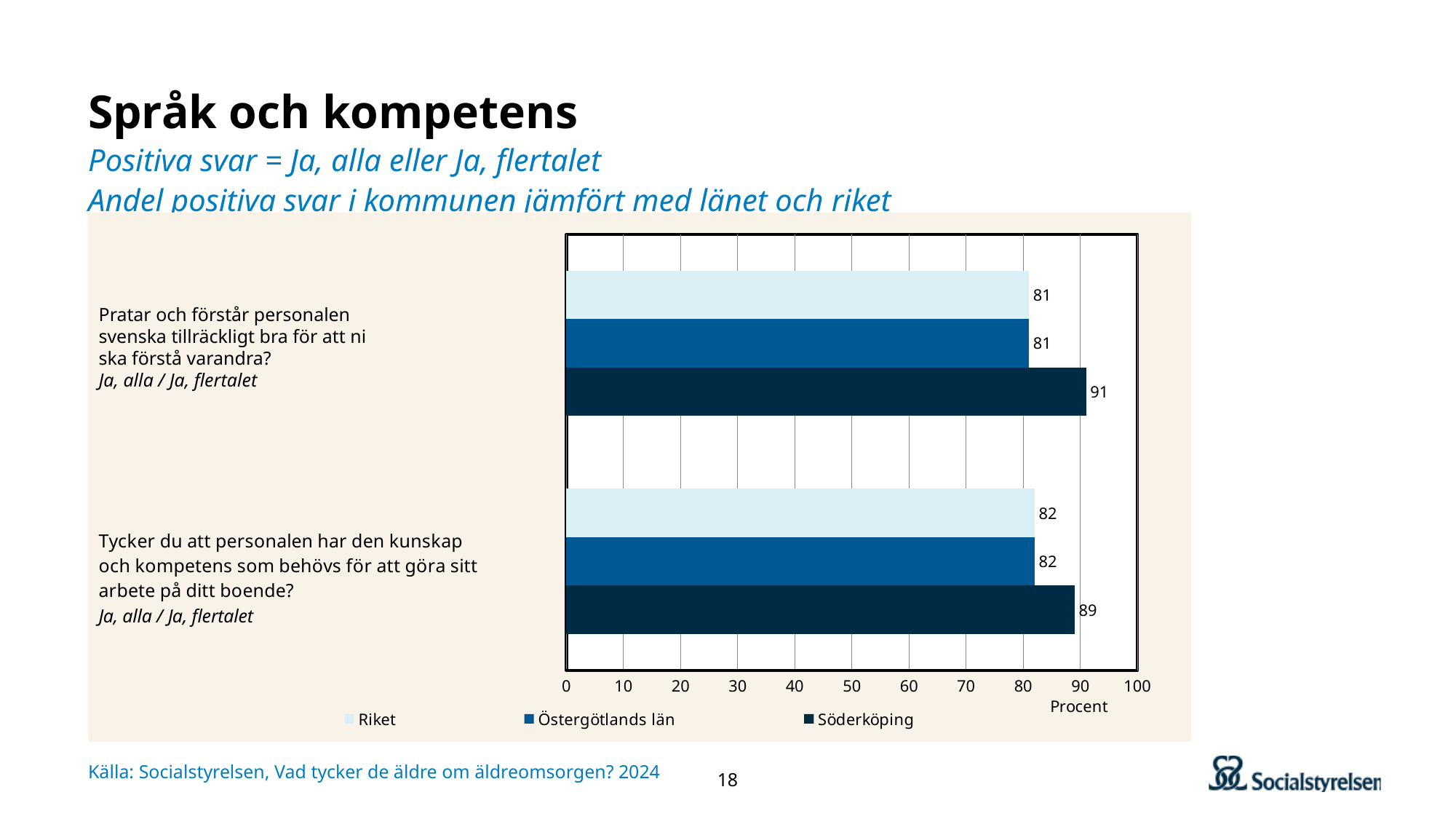
What unit is shown on the x axis of the chart? Procent What is the value for Östergötlands län on the question about staff speaking and understanding Swedish? 81 Which is larger: Söderköping's value on the Swedish-language question or Söderköping's value on the knowledge and competence question? Swedish-language question (91) Which series has the highest value on the question about staff speaking and understanding Swedish? Söderköping What is the difference between Söderköping and Riket on the question about staff speaking and understanding Swedish? 10 What is the value for Söderköping on the question about whether staff speak and understand Swedish well enough (Pratar och förstår personalen svenska tillräckligt bra)? 91 What is the value for Riket on the question about whether staff have the knowledge and competence needed (Tycker du att personalen har den kunskap och kompetens)? 82 How many series does the legend list? 3 What is the value for Söderköping on the question about staff knowledge and competence? 89 What is the difference between Söderköping and Östergötlands län on the question about staff knowledge and competence? 7 What kind of chart is shown on the slide? Bar chart How many questions (categories) are shown in the chart? 2